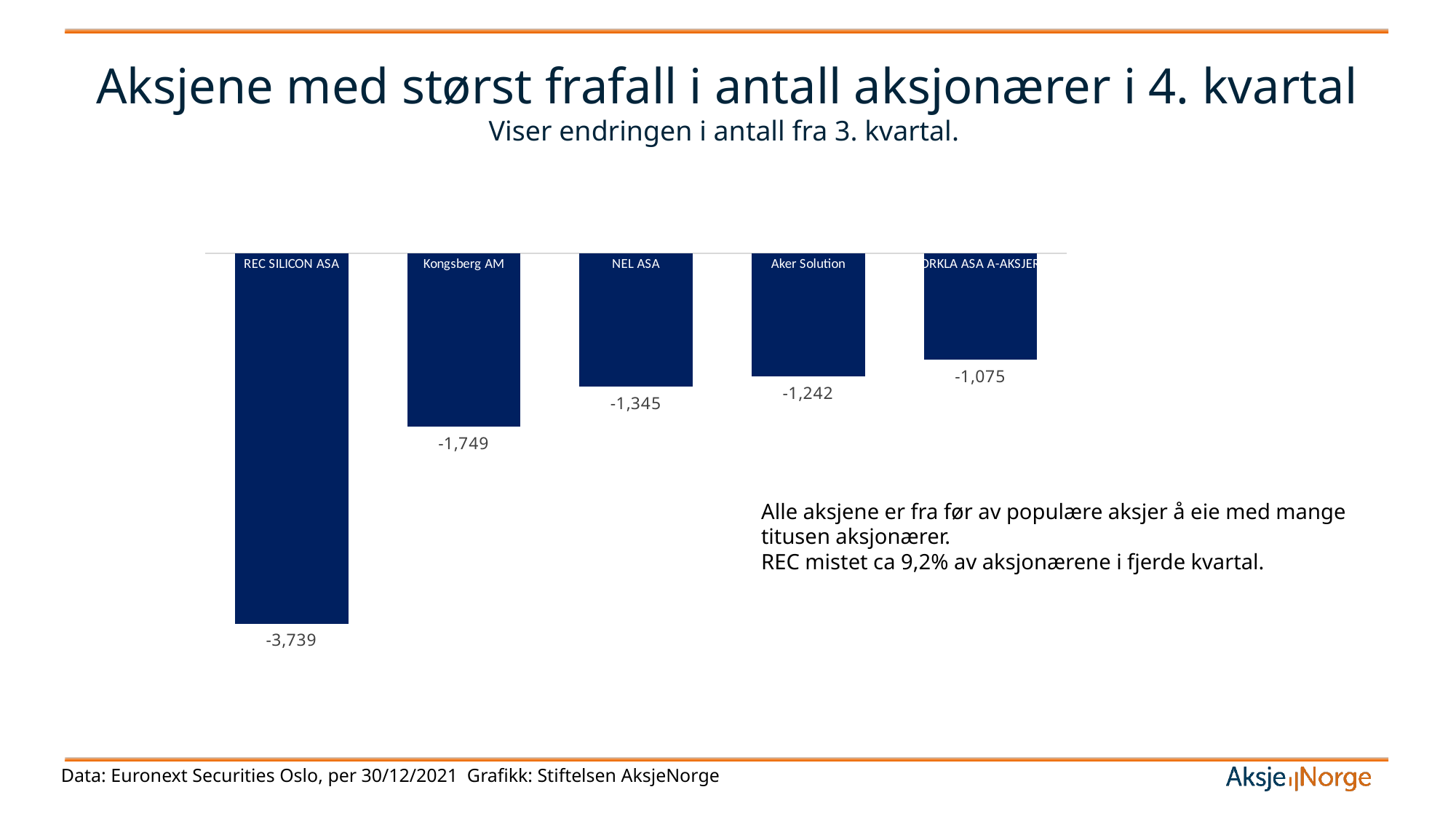
What is the title of the slide containing the chart? Aksjene med størst frafall i antall aksjonærer i 4. kvartal Which category has the lowest (most negative) value in the chart? REC SILICON ASA What is the value shown for Aker Solution? -1,242 What is the difference between the values for NEL ASA and Aker Solution? 103 What is the value shown for Kongsberg AM? -1,749 Which category has the smallest decline, i.e. the highest value in the chart? ORKLA ASA A-AKSJER What is the value shown for NEL ASA? -1,345 What is the value shown for REC SILICON ASA? -3,739 Which has a larger decline in number of shareholders, Kongsberg AM or NEL ASA? Kongsberg AM What kind of chart is shown on the slide? Bar chart How many categories (stocks) are shown in the chart? 5 What is the difference between the values for REC SILICON ASA and Kongsberg AM? 1,990